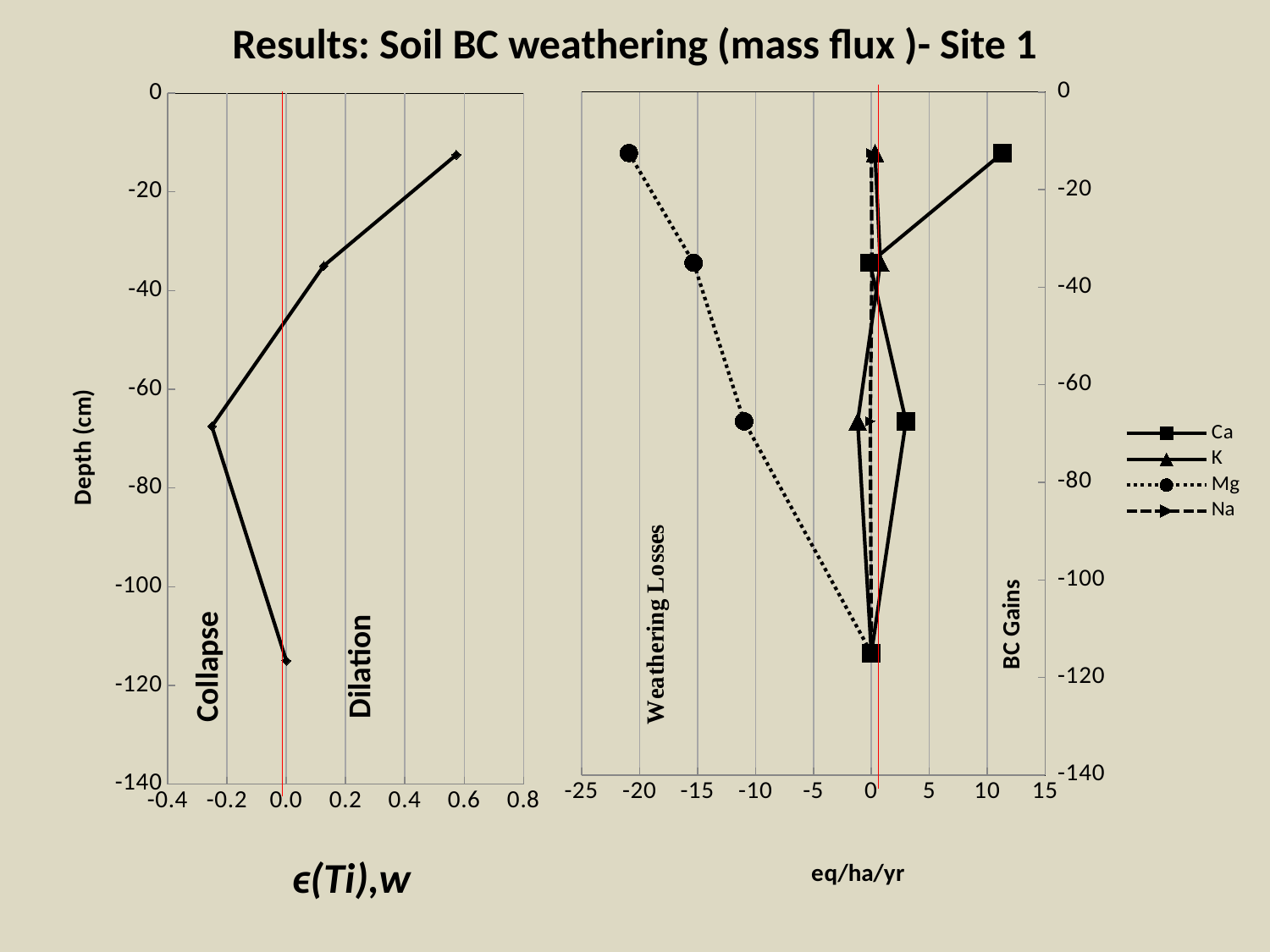
How many data points are plotted on the left chart (ε(Ti),w)? 4 In the left chart (ε(Ti),w), is the value at about -68 cm depth greater or less than 0? less In the left chart (ε(Ti),w), is the value at the shallowest depth (about -12 cm) greater or less than 0.4? greater In the right chart (eq/ha/yr), which series is drawn with a dotted line? Mg In the right chart (eq/ha/yr), which series has the most negative value at the shallowest depth? Mg In the right chart (eq/ha/yr), which series has the highest value at the shallowest depth? Ca How many series does the legend of the right chart (eq/ha/yr) list? 4 What kind of chart is the left chart (ε(Ti),w)? line chart In the right chart (eq/ha/yr), at about -68 cm depth, which is larger: the Ca value or the K value? Ca In the right chart (eq/ha/yr), is the Mg value at the shallowest depth greater or less than -15? less Which series are listed in the legend of the right chart (eq/ha/yr)? Ca, K, Mg, Na